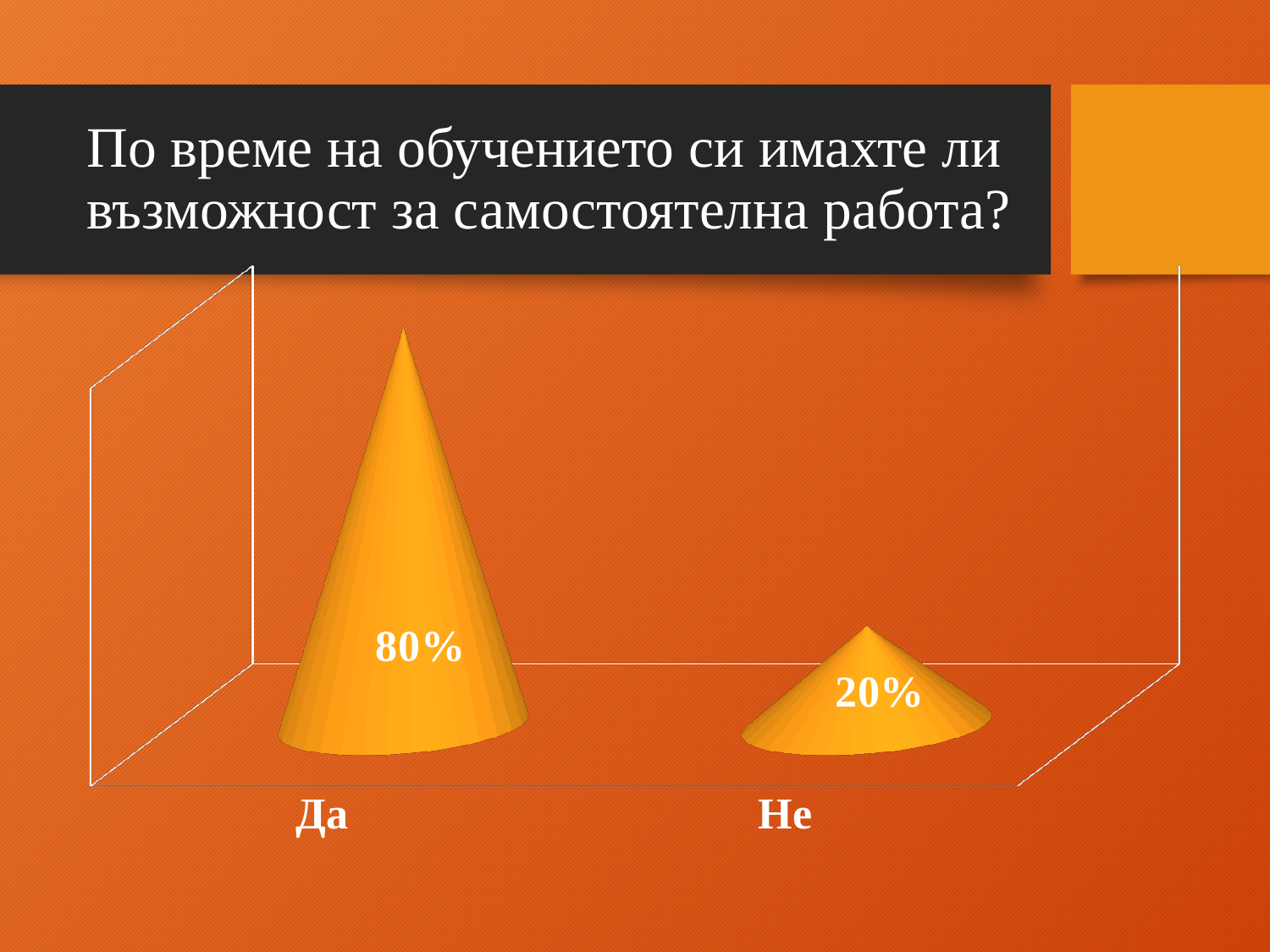
What is the total of the two values shown in the chart? 100% What colour are the bars in the chart? orange What is the value for "Да"? 80% Which category has the highest value? Да How many categories are shown in the chart? 2 What is the title of the slide containing the chart? По време на обучението си имахте ли възможност за самостоятелна работа? What kind of chart is shown on the slide? bar chart What is the value for "Не"? 20% Which category has the lowest value? Не What is the difference between the values for "Да" and "Не"? 60% Which is larger, the value for "Да" or the value for "Не"? Да